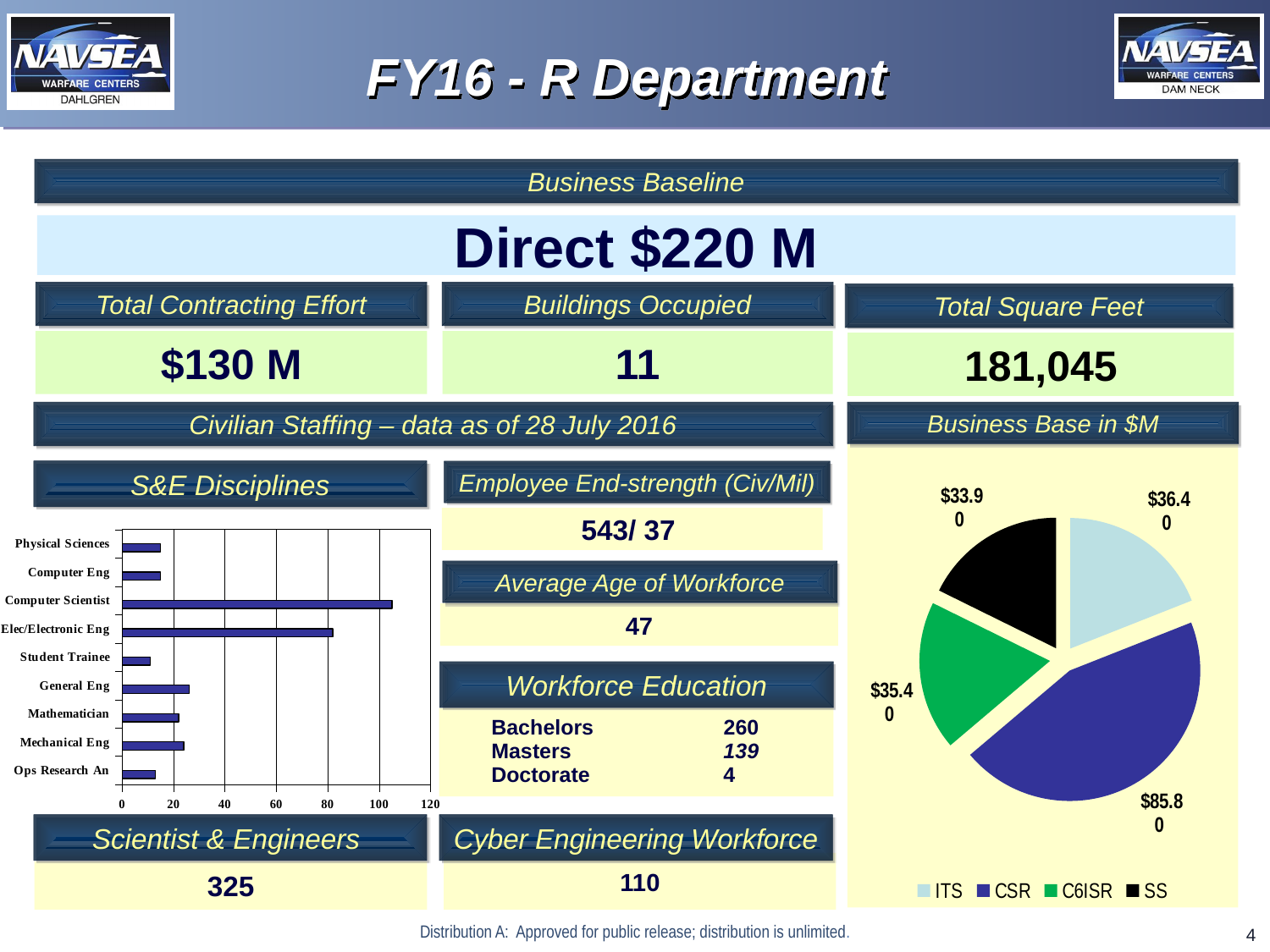
In the S&E Disciplines chart, which discipline has the longest bar? Computer Scientist In the S&E Disciplines chart, which discipline has the shortest bar? Student Trainee What kind of chart is the S&E Disciplines chart? bar chart In the S&E Disciplines chart, is the value for Computer Scientist greater or less than 100? greater In the Business Base in $M pie chart, which category has the largest slice? CSR In the S&E Disciplines chart, is the value for Student Trainee greater or less than 20? less In the Business Base in $M pie chart, what colour is the CSR slice? dark blue What kind of chart is the Business Base in $M chart? pie chart In the Business Base in $M pie chart, how many categories does the legend list? 4 In the S&E Disciplines chart, is the value for Elec/Electronic Eng greater or less than 60? greater In the S&E Disciplines chart, which is larger, the value for Elec/Electronic Eng or the value for General Eng? Elec/Electronic Eng In the S&E Disciplines chart, how many disciplines are listed on the axis? 9